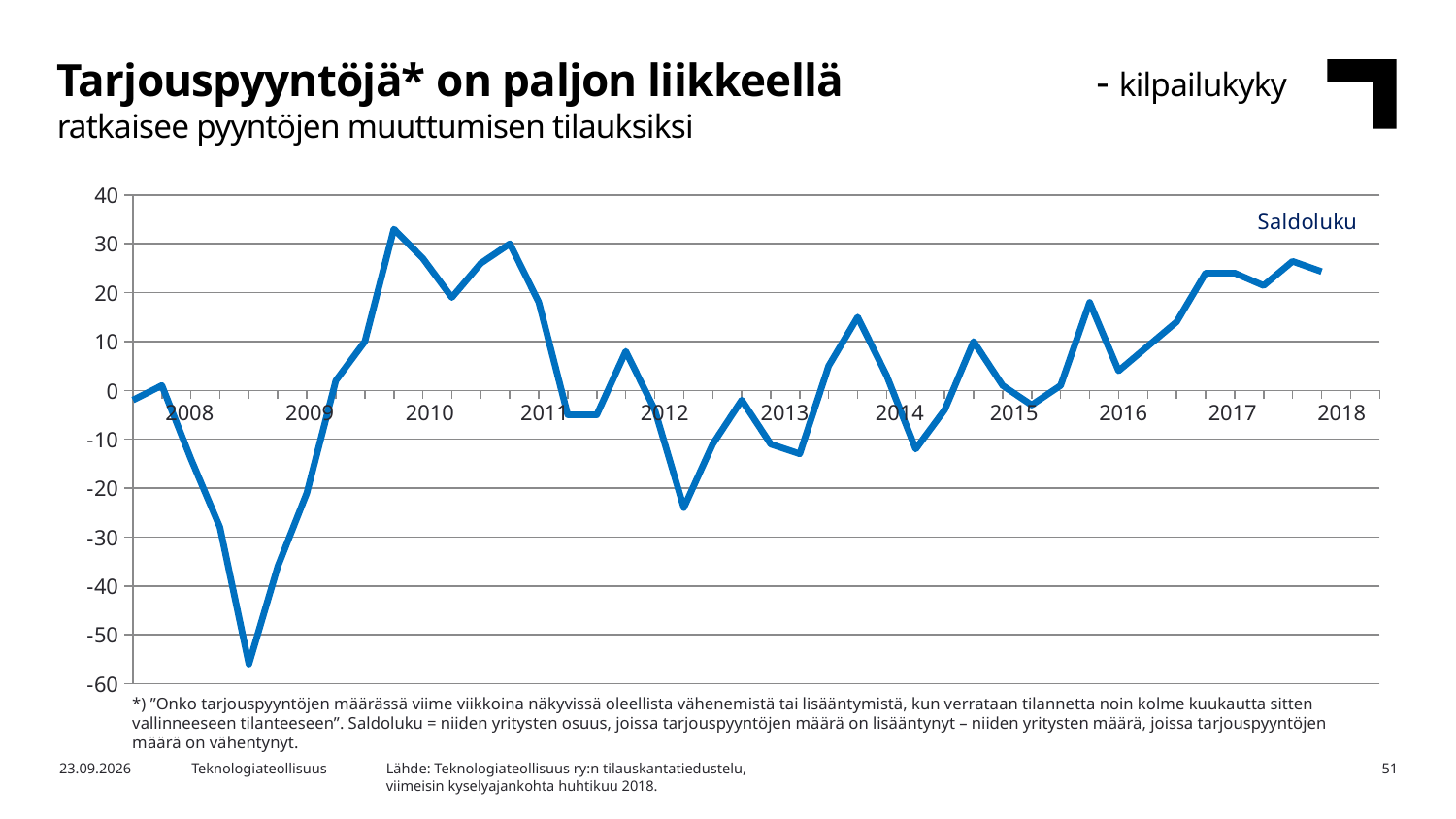
What is the lowest value shown on the y axis? -60 Is the lowest point of the line greater or less than -50? less What is the name of the series plotted on the chart? Saldoluku Is the value at the 2018 tick greater or less than 20? greater Does the line generally rise or fall from the 2015 tick to the 2018 tick? rise How many year labels are shown on the x axis? 11 Does the line rise or fall between the 2008 tick and the lowest point before 2009? fall Is the value at the 2012 tick greater or less than 0? less What kind of chart is shown on the slide? line chart How many data series does the chart show? 1